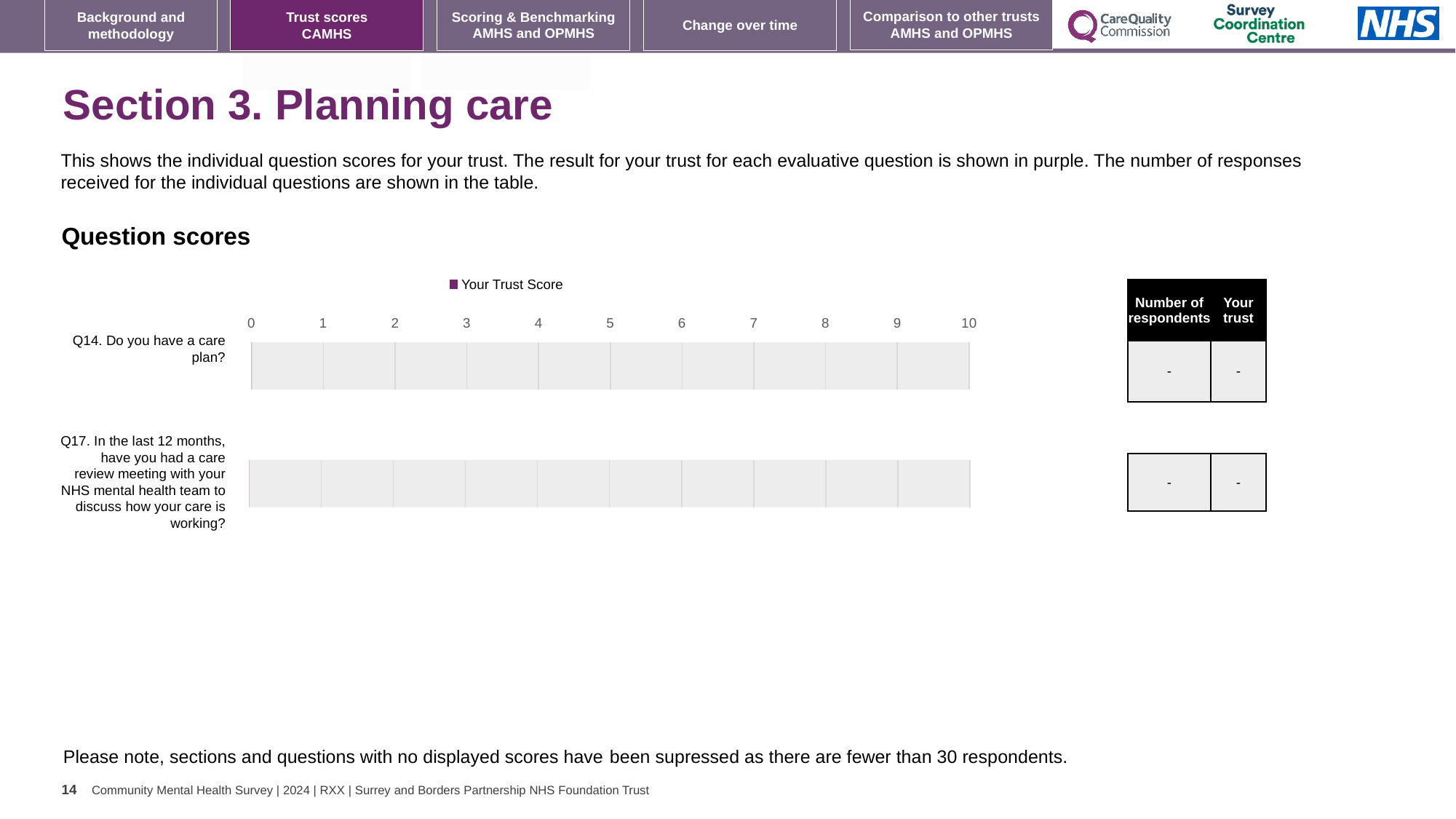
What kind of chart is shown under 'Question scores'? bar chart How many series does the chart legend list? 1 Is a score bar plotted for 'Q14. Do you have a care plan?' on the chart? No What is the name of the series shown in the chart legend? Your Trust Score What is shown in the 'Number of respondents' column of the table for Q14? - How many questions (categories) are listed on the chart's vertical axis? 2 What is the maximum value shown on the chart's horizontal axis? 10 What is shown in the 'Your trust' column of the table for Q17? -